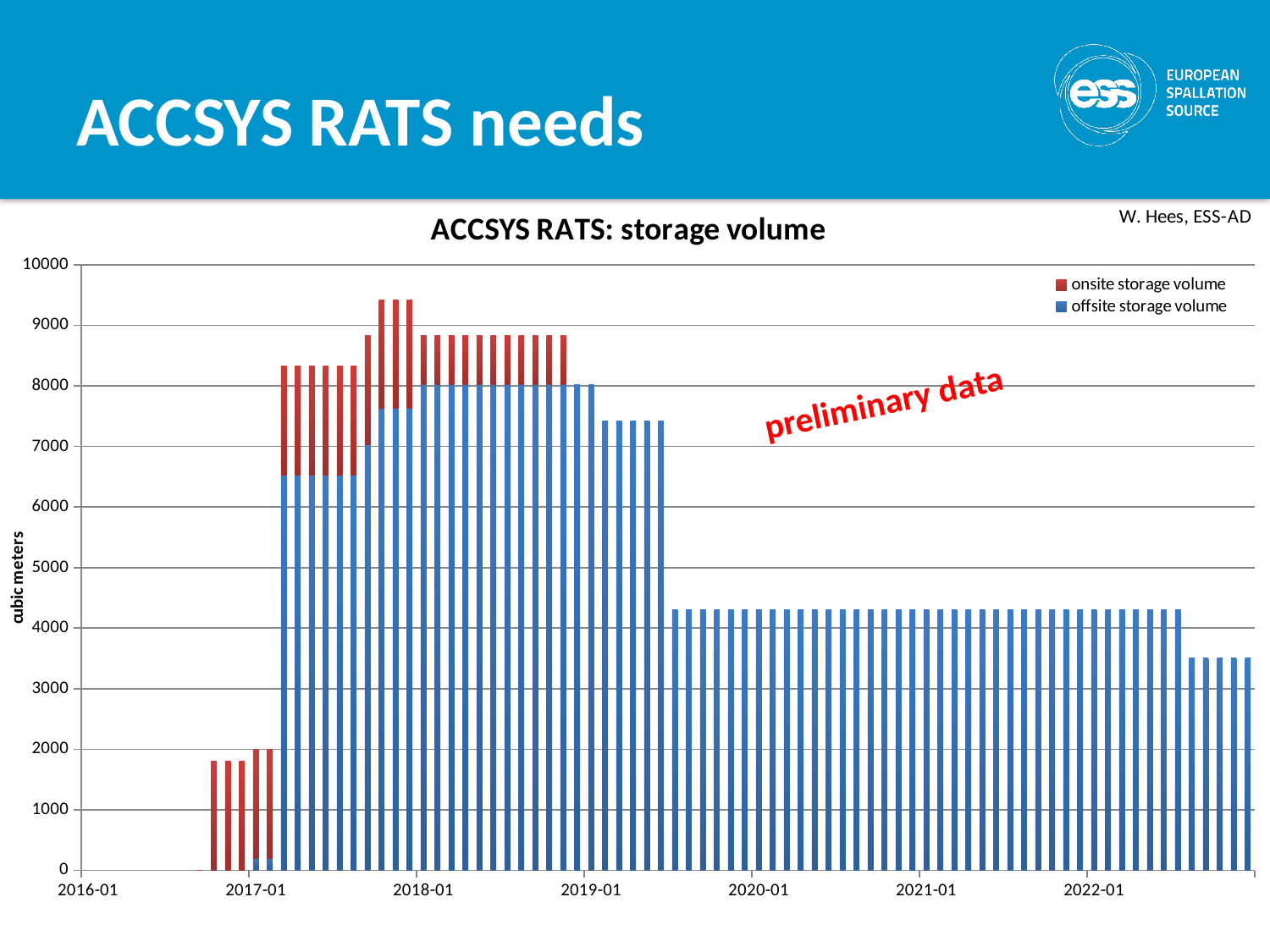
Are the last bars at the right end of the chart (late 2022) greater or less than 4000 cubic meters? less What kind of chart is shown on the slide? stacked bar chart Is the total storage volume at 2020-01 greater or less than 5000 cubic meters? less Is the total storage volume at 2021-01 greater or less than 5000 cubic meters? less What is the title of the chart? ACCSYS RATS: storage volume What is the label of the vertical axis? cubic meters Do the total storage volumes rise or fall from 2019-01 to 2022-01? fall Which is larger, the total storage volume at 2018-01 or at 2020-01? 2018-01 How many series does the legend list? 2 Which series is shown in red? onsite storage volume